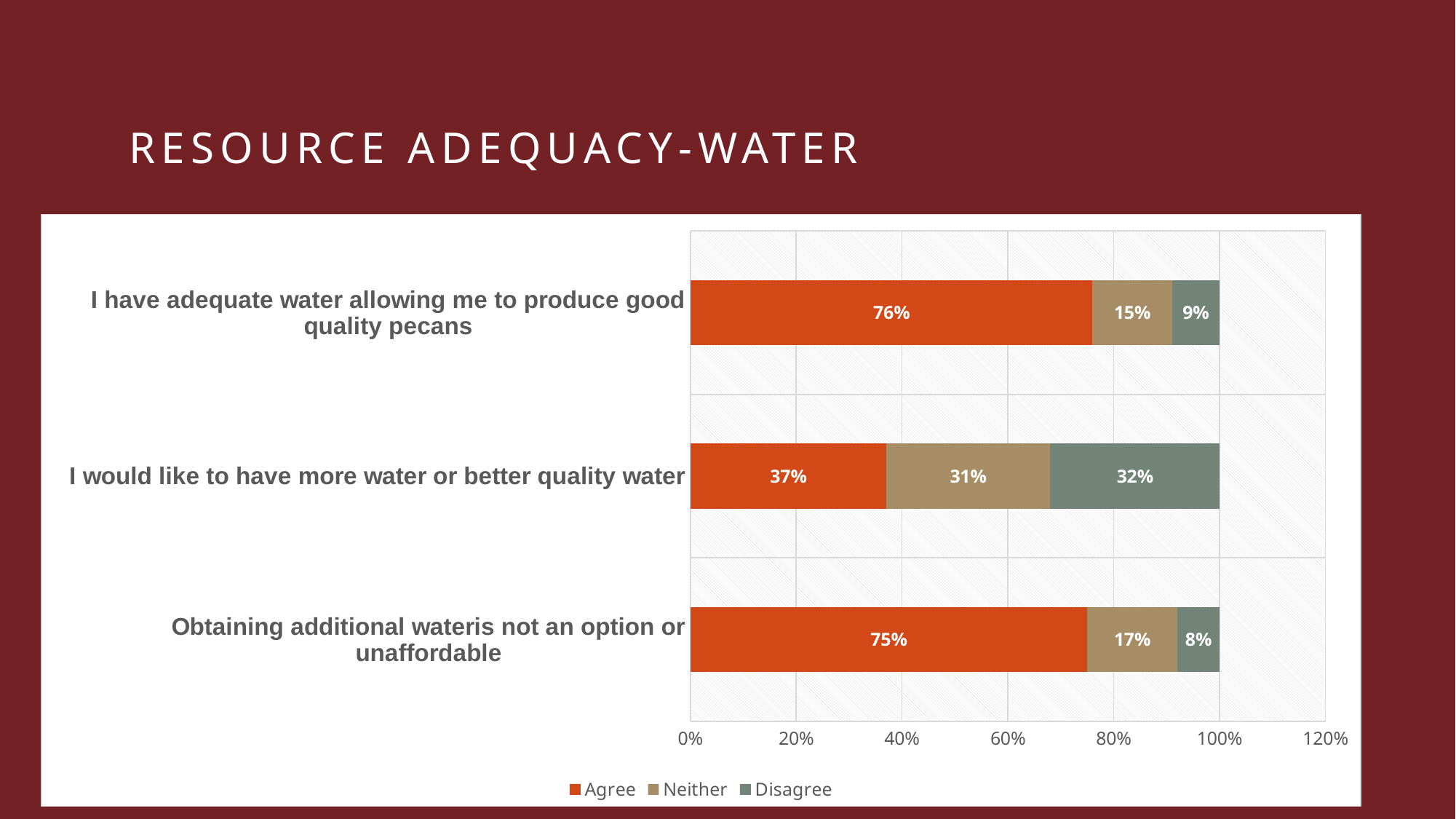
How many statements are shown on the chart? 3 What percentage agree with the statement "I have adequate water allowing me to produce good quality pecans"? 76% What is the Neither value for "Obtaining additional water is not an option or unaffordable"? 17% Which statement has the highest Agree percentage? I have adequate water allowing me to produce good quality pecans Is the Agree value for "Obtaining additional water is not an option or unaffordable" greater or less than 60%? greater What kind of chart is shown on the slide? Stacked bar chart Is the Neither percentage larger for "I would like to have more water or better quality water" or for "I have adequate water allowing me to produce good quality pecans"? I would like to have more water or better quality water How many series does the legend list? 3 What is the total of the stacked bar for "I have adequate water allowing me to produce good quality pecans"? 100% What percentage disagree with the statement "I would like to have more water or better quality water"? 32% Which statement has the lowest Disagree percentage? Obtaining additional water is not an option or unaffordable What is the difference between the Agree and Disagree percentages for "I would like to have more water or better quality water"? 5%